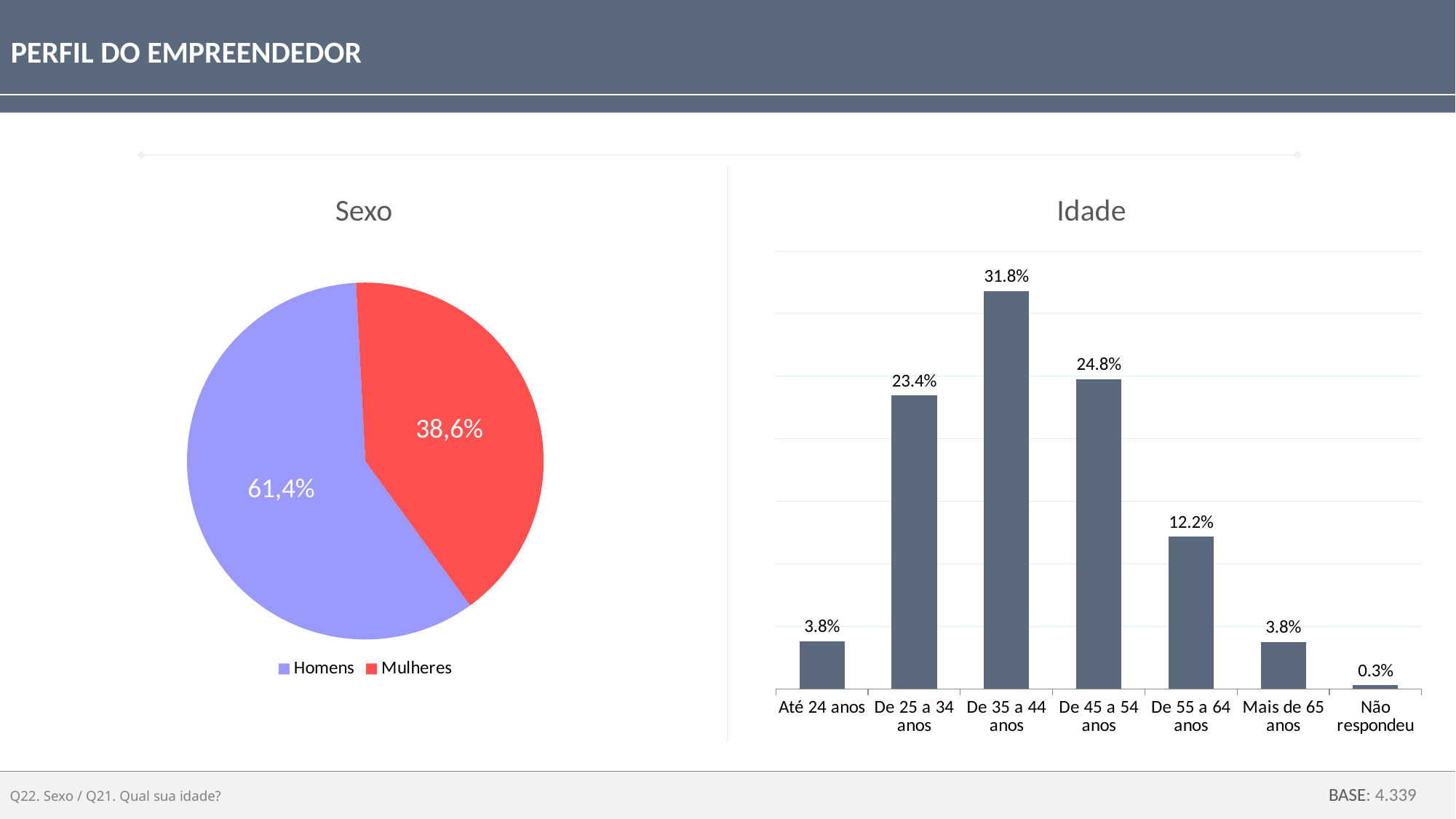
In the 'Sexo' chart, what share is labelled for Homens? 61,4% In the 'Idade' chart, what is the value for 'De 35 a 44 anos'? 31.8% In the 'Sexo' chart, what share is labelled for Mulheres? 38,6% In the 'Idade' chart, which category has the highest value? De 35 a 44 anos In the 'Idade' chart, which is larger: 'De 45 a 54 anos' or 'De 55 a 64 anos'? De 45 a 54 anos In the 'Idade' chart, what is the value for 'De 55 a 64 anos'? 12.2% In the 'Idade' chart, what is the difference between 'De 45 a 54 anos' and 'De 25 a 34 anos'? 1.4% In the 'Sexo' chart, how many entries does the legend list? 2 What kind of chart is the 'Sexo' chart? pie chart What kind of chart is the 'Idade' chart? bar chart In the 'Idade' chart, which category has the lowest value? Não respondeu How many categories are shown in the 'Idade' chart? 7